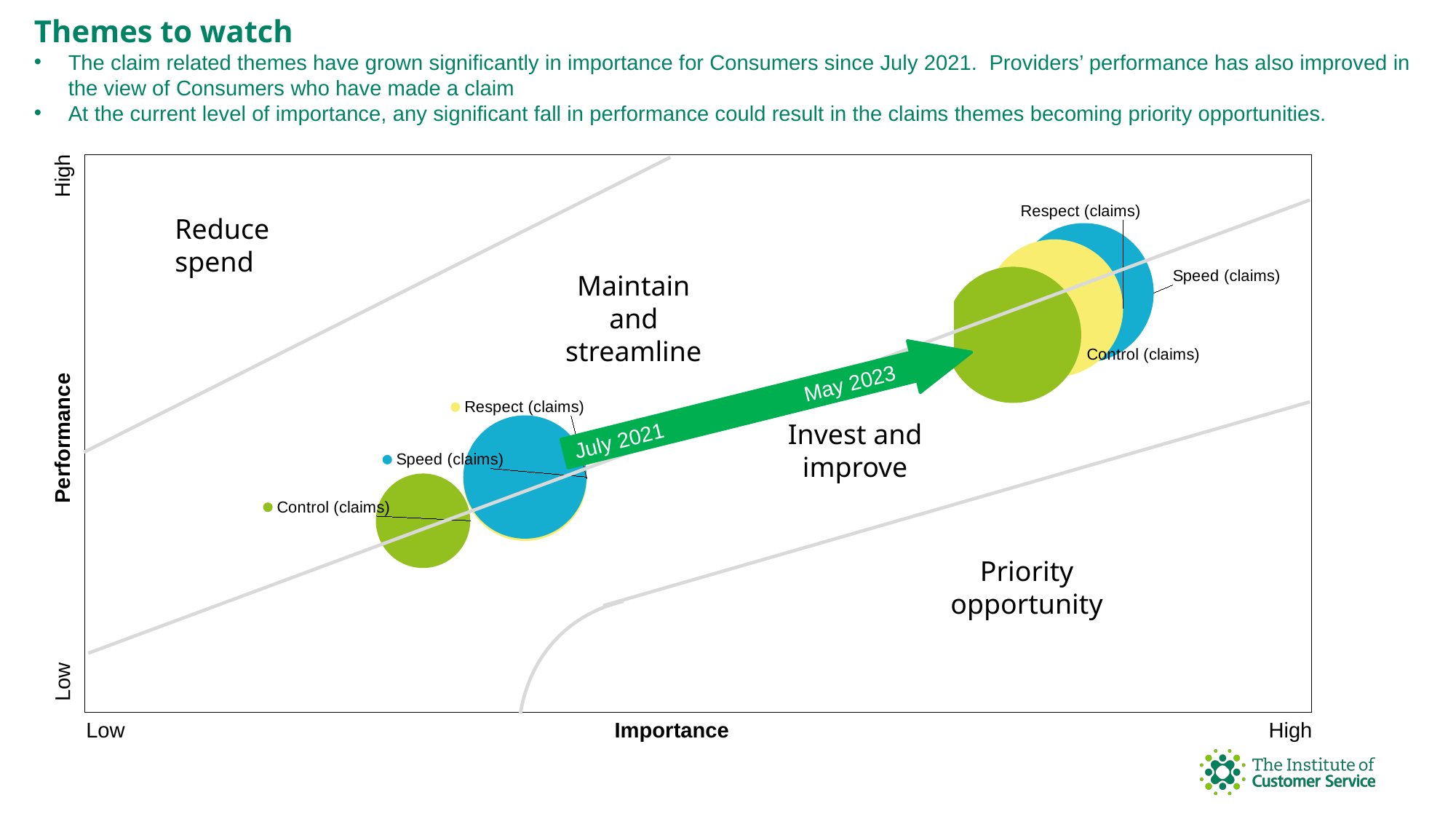
What label is on the vertical axis of the chart? Performance What label is on the horizontal axis of the chart? Importance Between July 2021 and May 2023, did the performance of the claims themes rise or fall? Rise Which two time points are compared on the chart? July 2021 and May 2023 How many claims themes are plotted on the chart? 3 In May 2023, which had lower performance: Control (claims) or Respect (claims)? Control (claims) What kind of chart is shown on the slide? Bubble chart In July 2021, which of the three claims themes had the lowest importance? Control (claims) In July 2021, which had higher performance: Control (claims) or Speed (claims)? Speed (claims) Between July 2021 and May 2023, did the importance of the claims themes rise or fall? Rise In May 2023, which of the three claims themes had the highest importance? Speed (claims)